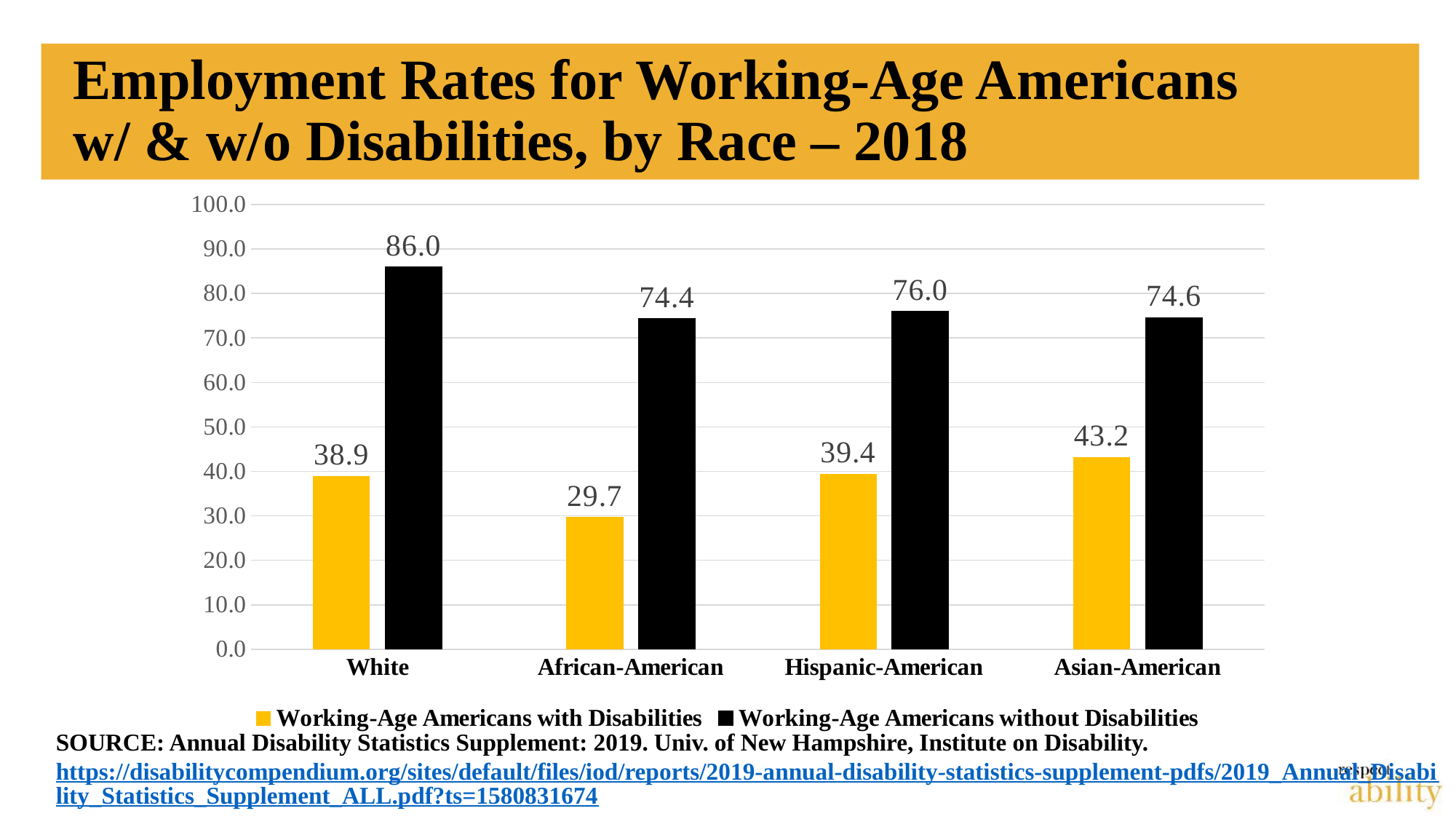
Which race category has the highest employment rate for Working-Age Americans without Disabilities? White Which race category has the lowest employment rate for Working-Age Americans with Disabilities? African-American How many series does the legend list? 2 What is the employment rate for Working-Age Americans with Disabilities in the Asian-American category? 43.2 What is the difference between the employment rates for Working-Age Americans without Disabilities and with Disabilities in the White category? 47.1 What is the employment rate for Working-Age Americans without Disabilities in the Hispanic-American category? 76.0 What colour represents Working-Age Americans with Disabilities in the chart? Yellow How many race categories are shown on the x axis? 4 What kind of chart is shown on the slide? Bar chart Which is larger: the employment rate for Working-Age Americans with Disabilities in the Hispanic-American category or in the White category? Hispanic-American What is the difference between the employment rates for Working-Age Americans with Disabilities in the Asian-American and African-American categories? 13.5 What is the employment rate for Working-Age Americans with Disabilities in the White category? 38.9